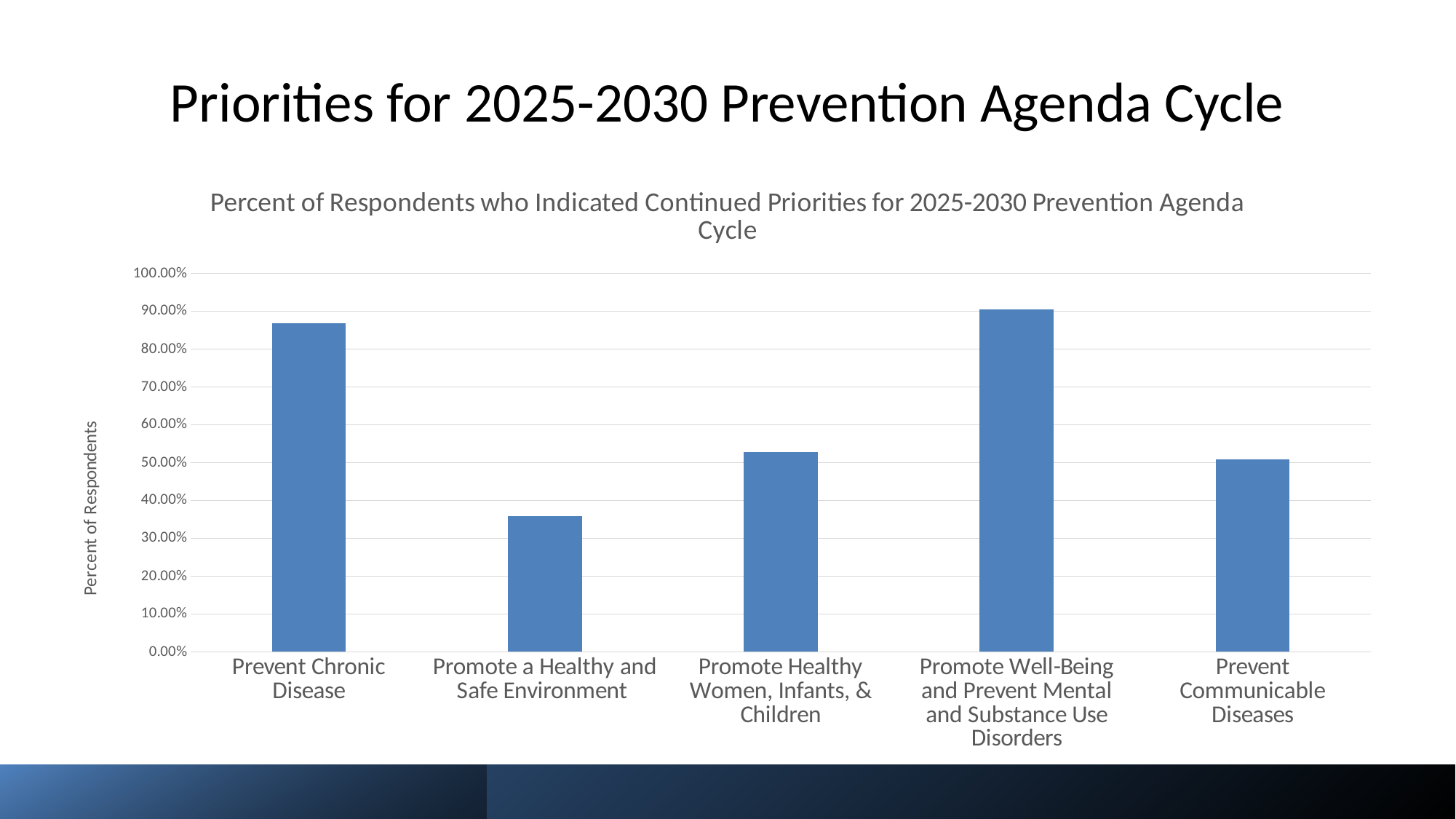
What kind of chart is shown on the slide? Bar chart Is the value for Promote a Healthy and Safe Environment greater or less than 40.00%? less Which priority has the highest percent of respondents? Promote Well-Being and Prevent Mental and Substance Use Disorders Which priority has the lowest percent of respondents? Promote a Healthy and Safe Environment Is the value for Promote Healthy Women, Infants, & Children greater or less than 60.00%? less What is the title of the chart? Percent of Respondents who Indicated Continued Priorities for 2025-2030 Prevention Agenda Cycle Is the value for Prevent Chronic Disease greater or less than 80.00%? greater How many priority categories are plotted on the chart? 5 What is the label on the vertical axis of the chart? Percent of Respondents Which has a higher percent of respondents: Prevent Chronic Disease or Promote Healthy Women, Infants, & Children? Prevent Chronic Disease